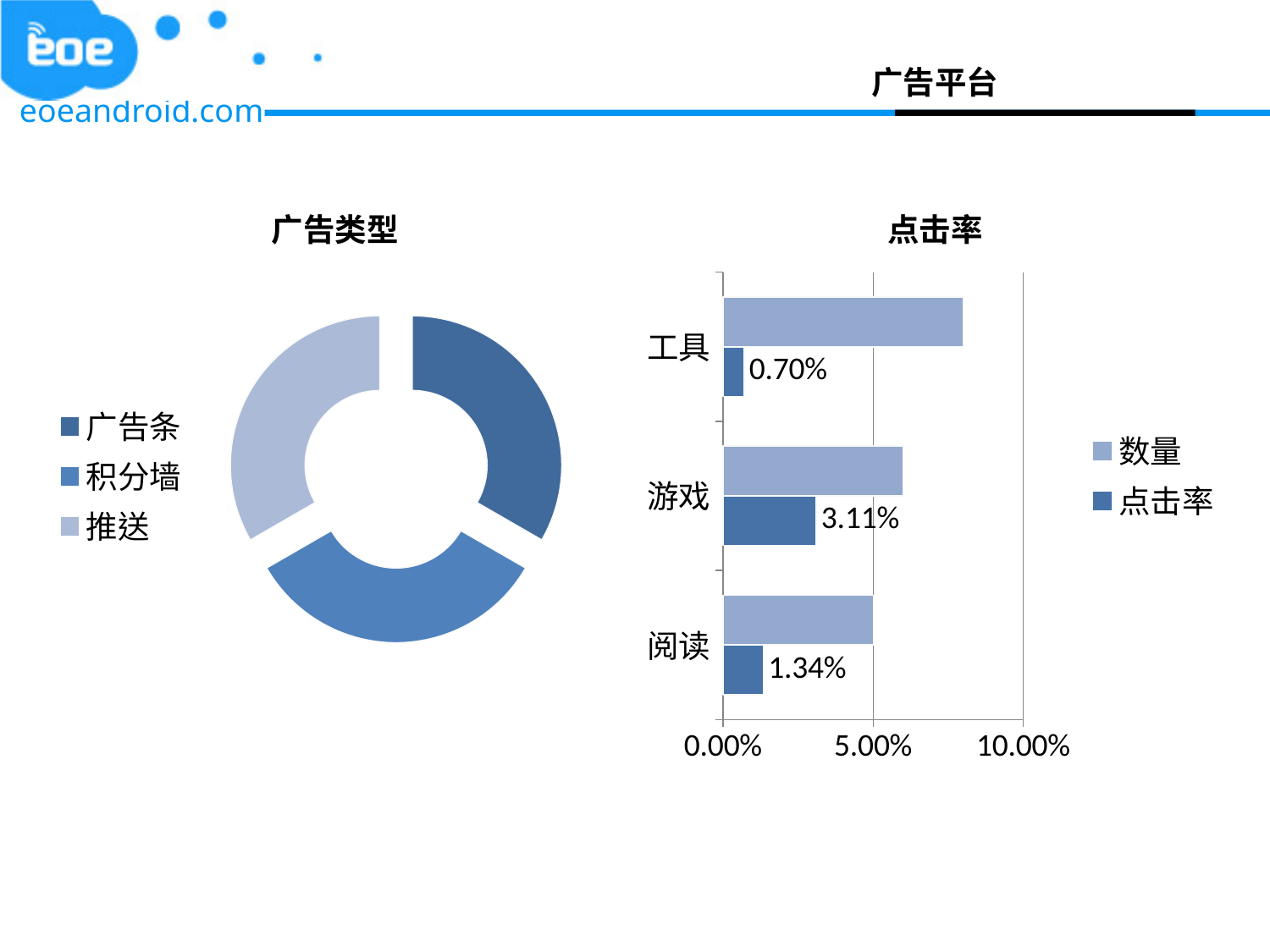
In the right chart (点击率), which category has the highest 点击率? 游戏 In the right chart (点击率), what is the 点击率 value for 阅读? 1.34% What kind of chart is the right chart titled 点击率? bar chart What kind of chart is the left chart titled 广告类型? doughnut chart How many entries does the legend of the left chart (广告类型) list? 3 In the right chart (点击率), which category has the lowest 点击率? 工具 How many series does the legend of the right chart (点击率) list? 2 In the right chart (点击率), what is the difference between the 点击率 of 游戏 and 阅读? 1.77% In the right chart (点击率), is the 数量 value for 工具 greater or less than 5.00%? greater In the right chart (点击率), what is the 点击率 value for 游戏? 3.11% In the right chart (点击率), what is the 点击率 value for 工具? 0.70% How many categories are shown on the right chart (点击率)? 3